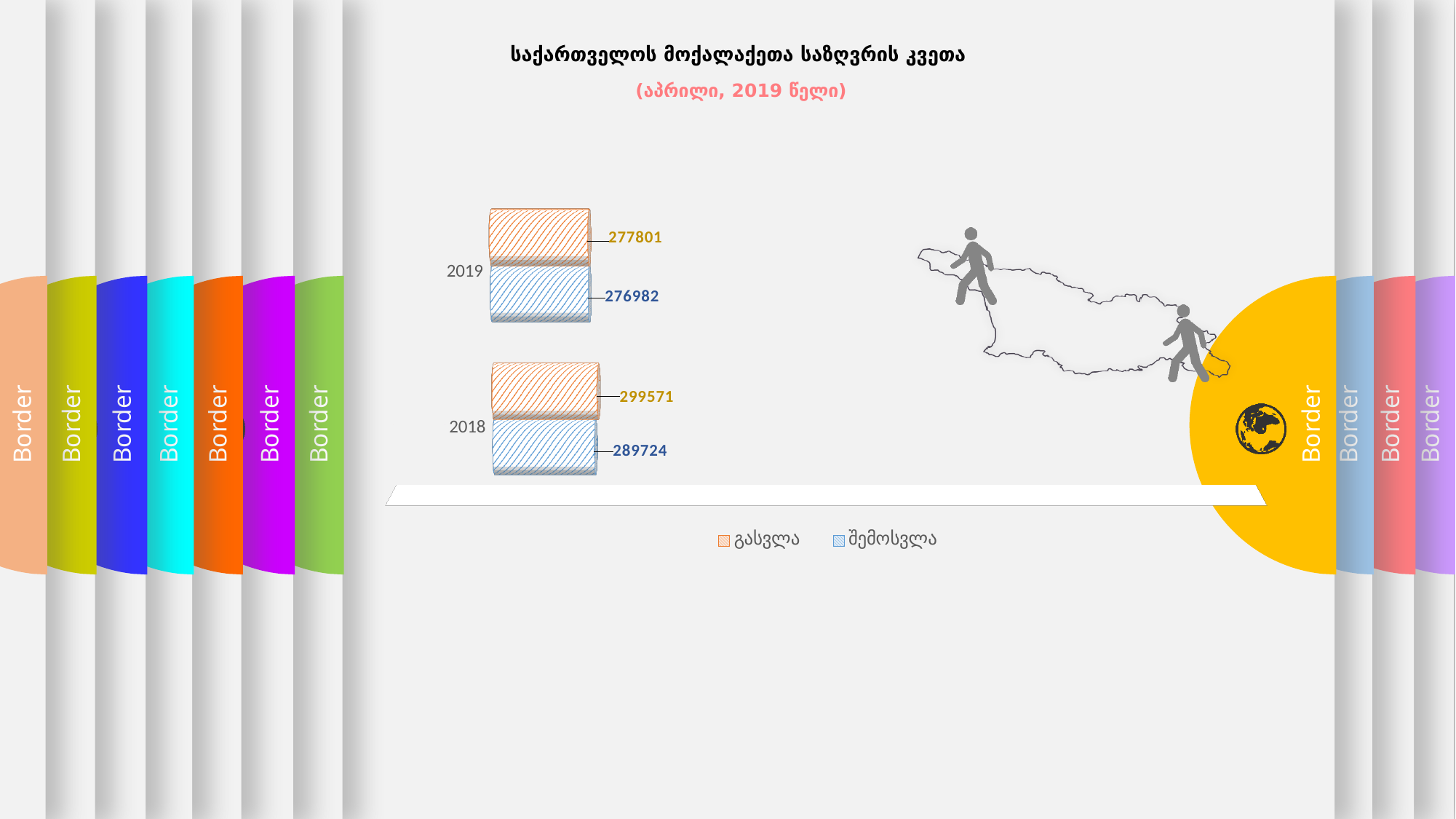
What kind of chart is shown on the slide? bar chart Which is larger in 2019, გასვლა or შემოსვლა? გასვლა Which year has the higher value for გასვლა? 2018 How many series does the legend list? 2 What is the value for გასვლა in 2018? 299571 What is the value for შემოსვლა in 2019? 276982 What is the value for შემოსვლა in 2018? 289724 How many years are shown on the chart? 2 What is the difference between გასვლა and შემოსვლა in 2018? 9847 Which year has the lower value for შემოსვლა? 2019 What is the difference between the გასვლა values for 2018 and 2019? 21770 What is the value for გასვლა in 2019? 277801